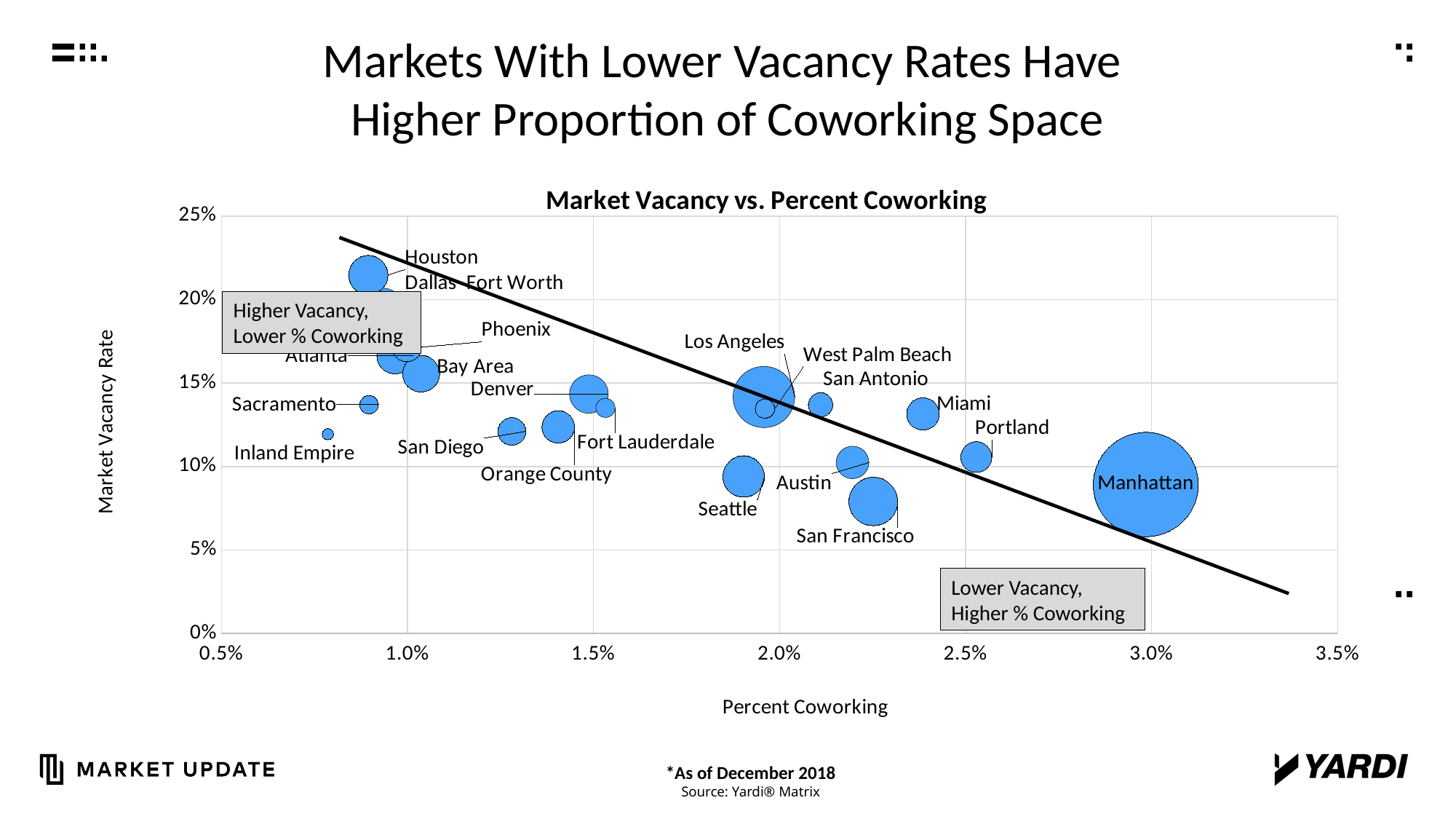
What is the label of the vertical axis of the chart? Market Vacancy Rate Which market has the highest percent coworking? Manhattan Which market has the highest market vacancy rate? Houston Is the percent coworking for Manhattan greater or less than 2.5%? greater As percent coworking increases along the x axis, does the market vacancy rate generally rise or fall? Fall Is the percent coworking for Inland Empire greater or less than 1.0%? less Which market has the lowest percent coworking? Inland Empire Which market has a higher percent coworking, Manhattan or Sacramento? Manhattan Which market has a higher market vacancy rate, Houston or Seattle? Houston What is the title of the chart? Market Vacancy vs. Percent Coworking What kind of chart is shown on the slide? Bubble chart Is the market vacancy rate for Houston greater or less than 20%? greater